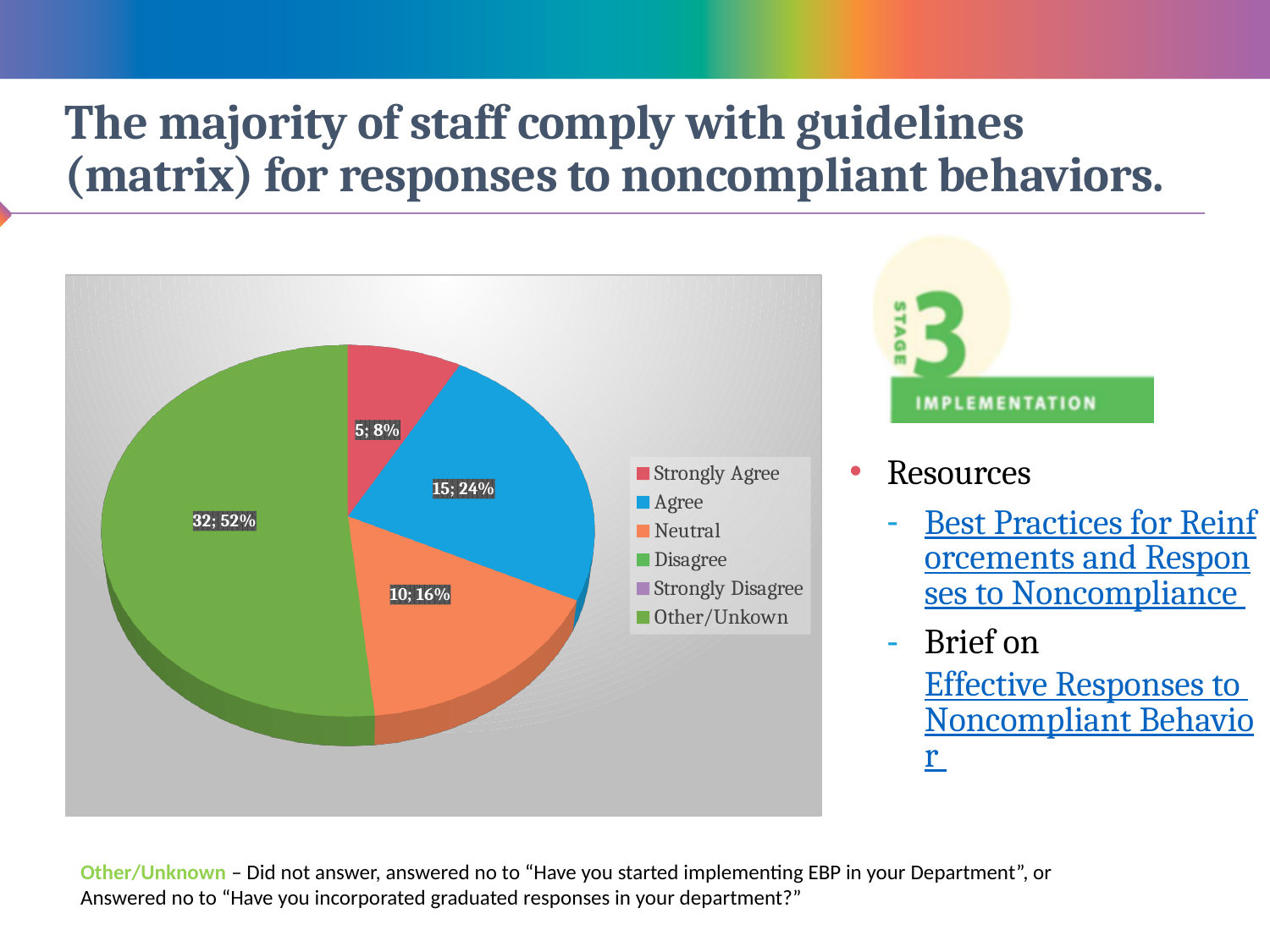
What percentage of the pie is the Other/Unknown slice? 52% How many entries does the chart's legend list? 6 Which slice is larger, Agree or Neutral? Agree Which category has the largest slice of the pie? Other/Unknown What is the difference in the number of responses between Agree and Neutral? 5 How many responses are in the Agree slice? 15 What is the total number of responses across the four labeled slices? 62 What kind of chart is shown on the slide? pie chart Among the slices with data labels, which category has the smallest slice? Strongly Agree What share of the pie does the Neutral slice represent? 16% How many responses are in the Strongly Agree slice? 5 What colour is the Other/Unknown slice in the pie chart? green